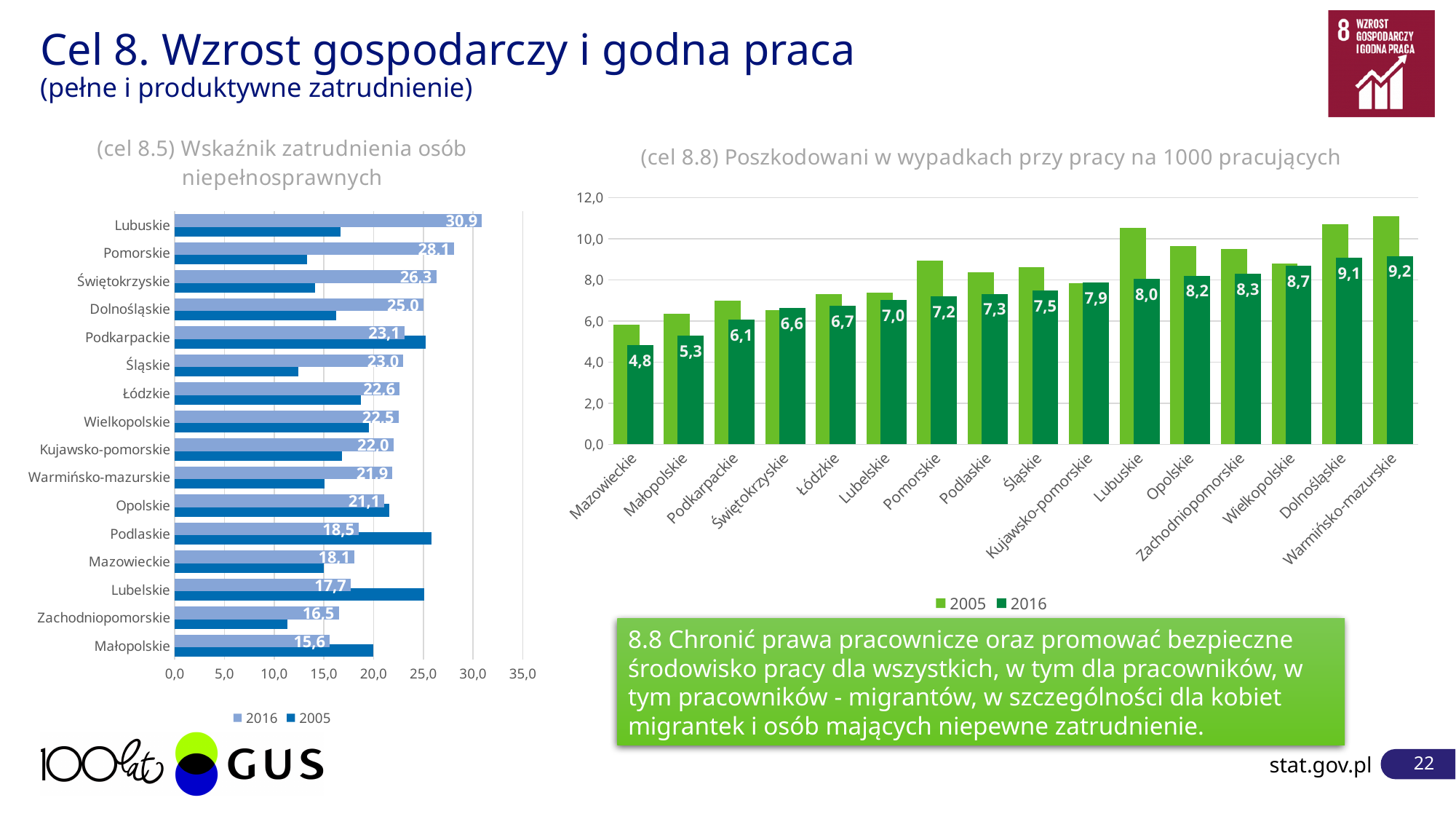
In the chart '(cel 8.8) Poszkodowani w wypadkach przy pracy na 1000 pracujących', do the 2016 values rise or fall from left to right along the x axis? rise In the chart '(cel 8.8) Poszkodowani w wypadkach przy pracy na 1000 pracujących', how many series does the legend list? 2 In the chart '(cel 8.5) Wskaźnik zatrudnienia osób niepełnosprawnych', is the 2005 value for Podlaskie greater or less than 25,0? greater In the chart '(cel 8.8) Poszkodowani w wypadkach przy pracy na 1000 pracujących', is the 2005 value for Lubuskie greater or less than 10,0? greater In the chart '(cel 8.5) Wskaźnik zatrudnienia osób niepełnosprawnych', what is the 2016 value for Lubuskie? 30,9 In the chart '(cel 8.8) Poszkodowani w wypadkach przy pracy na 1000 pracujących', which voivodeship has the highest 2016 value? Warmińsko-mazurskie In the chart '(cel 8.5) Wskaźnik zatrudnienia osób niepełnosprawnych', which series is larger for Lubelskie, 2016 or 2005? 2005 In the chart '(cel 8.5) Wskaźnik zatrudnienia osób niepełnosprawnych', which voivodeship has the lowest 2016 value? Małopolskie In the chart '(cel 8.5) Wskaźnik zatrudnienia osób niepełnosprawnych', what is the difference between the 2016 values for Pomorskie and Podlaskie? 9,6 What kind of chart is '(cel 8.5) Wskaźnik zatrudnienia osób niepełnosprawnych'? bar chart In the chart '(cel 8.8) Poszkodowani w wypadkach przy pracy na 1000 pracujących', what is the 2016 value for Mazowieckie? 4,8 In the chart '(cel 8.5) Wskaźnik zatrudnienia osób niepełnosprawnych', how many voivodeships are listed? 16